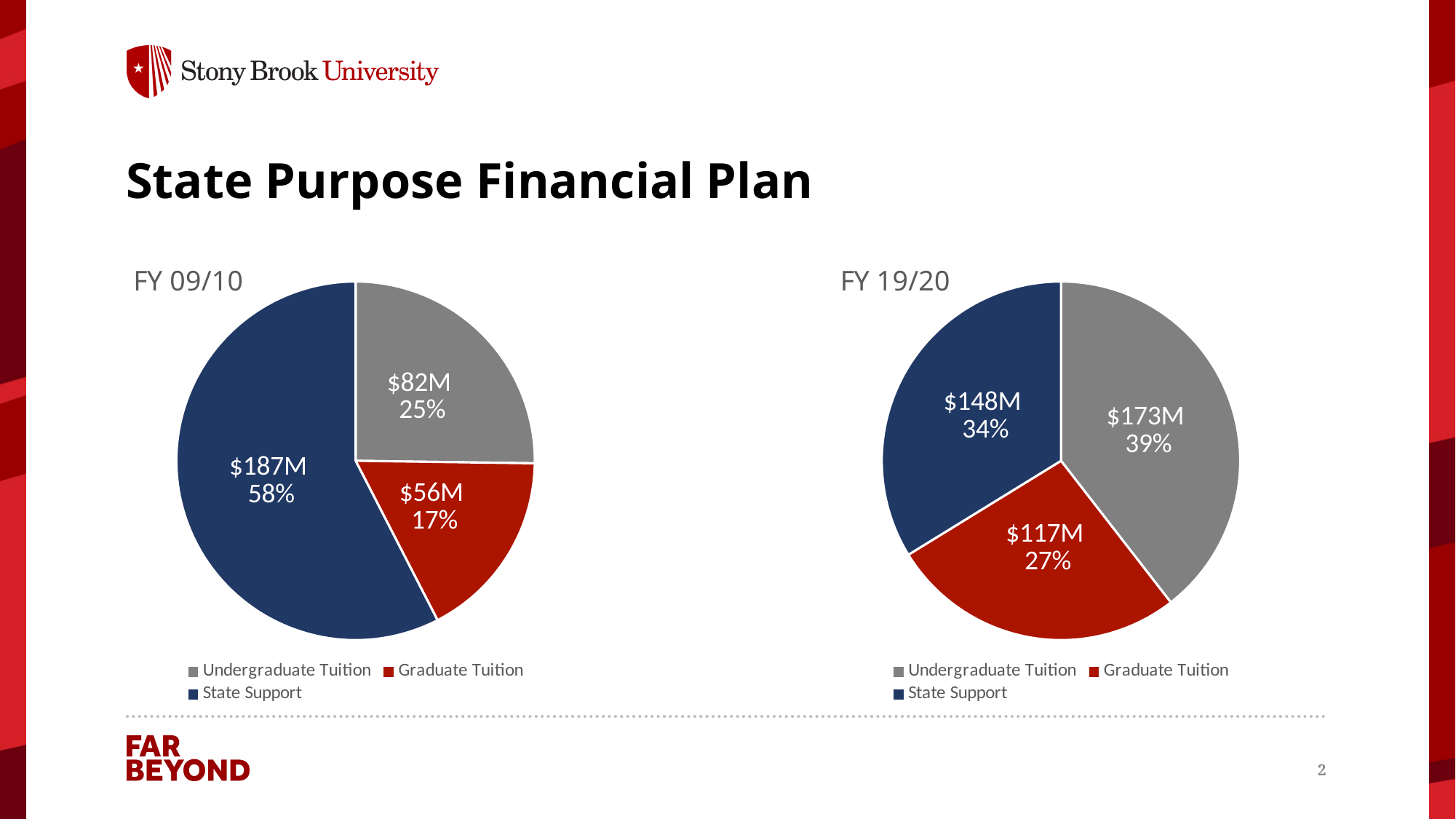
In the FY 09/10 pie chart, which category has the largest value? State Support In the FY 09/10 pie chart, what share of the pie is Undergraduate Tuition? 25% In the FY 09/10 pie chart, what colour is the State Support slice? Dark blue What kind of chart is the FY 09/10 chart? Pie chart In the FY 19/20 pie chart, what is the value for Graduate Tuition? $117M What is the title of the slide containing the two pie charts? State Purpose Financial Plan In the FY 19/20 pie chart, what is the difference between Undergraduate Tuition and State Support? $25M In the FY 19/20 pie chart, what share of the pie is State Support? 34% In the FY 09/10 pie chart, what is the value for State Support? $187M In the FY 09/10 pie chart, which is larger, Undergraduate Tuition or Graduate Tuition? Undergraduate Tuition How many slices does the FY 19/20 pie chart have? 3 In the FY 19/20 pie chart, which category has the smallest value? Graduate Tuition